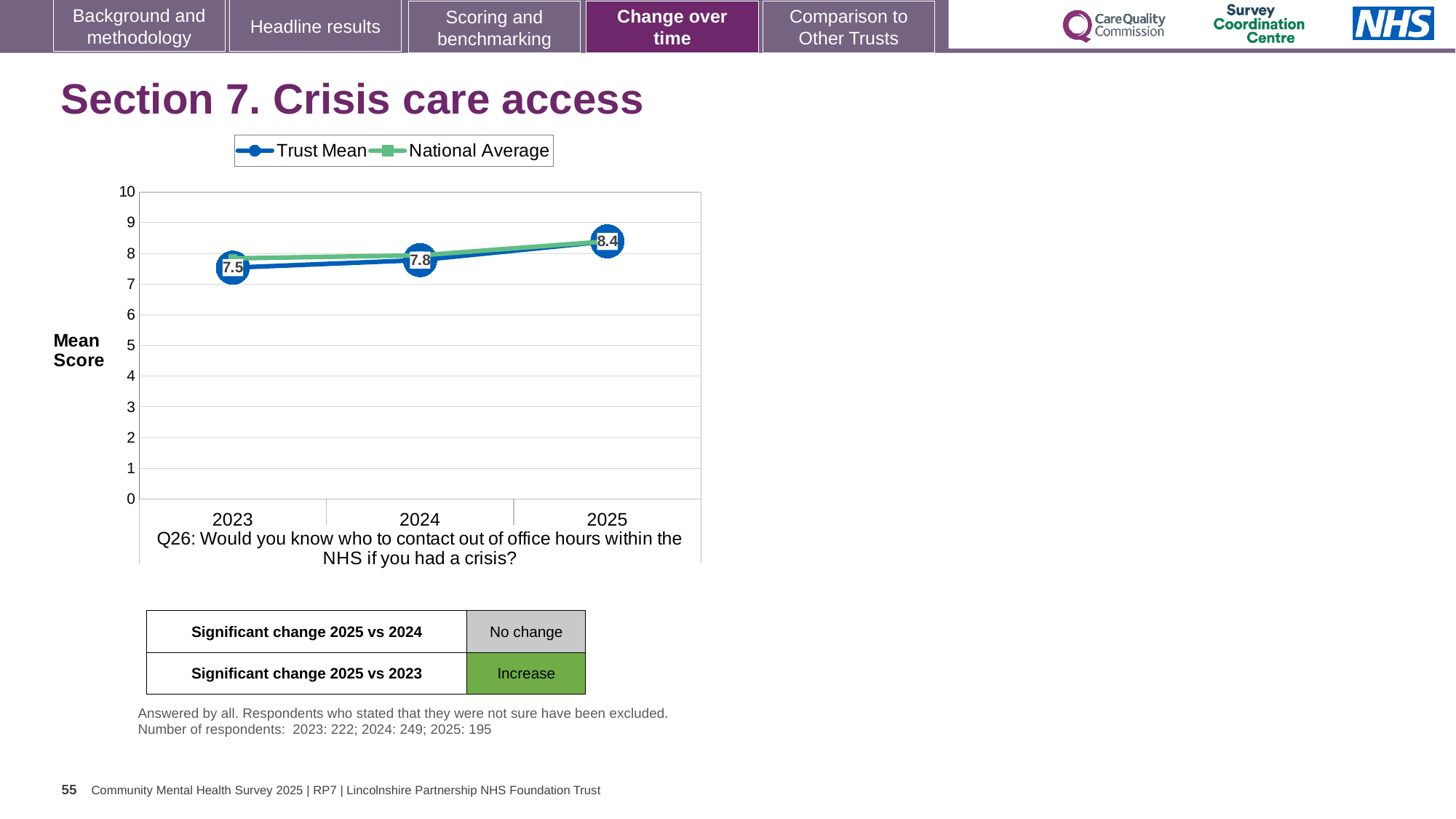
What is the difference between the Trust Mean score in 2025 and in 2023? 0.9 In which year is the Trust Mean score lowest? 2023 In which year is the Trust Mean score highest? 2025 How many series does the legend list? 2 Does the Trust Mean score rise or fall from 2023 to 2025? Rise Which is larger, the Trust Mean score in 2024 or in 2025? 2025 What is the Trust Mean score for 2025? 8.4 What is the Trust Mean score for 2024? 7.8 What is the Trust Mean score for 2023? 7.5 How many years are shown on the x axis? 3 Is the National Average value for 2023 greater or less than 7? greater What kind of chart is shown on the slide? Line chart